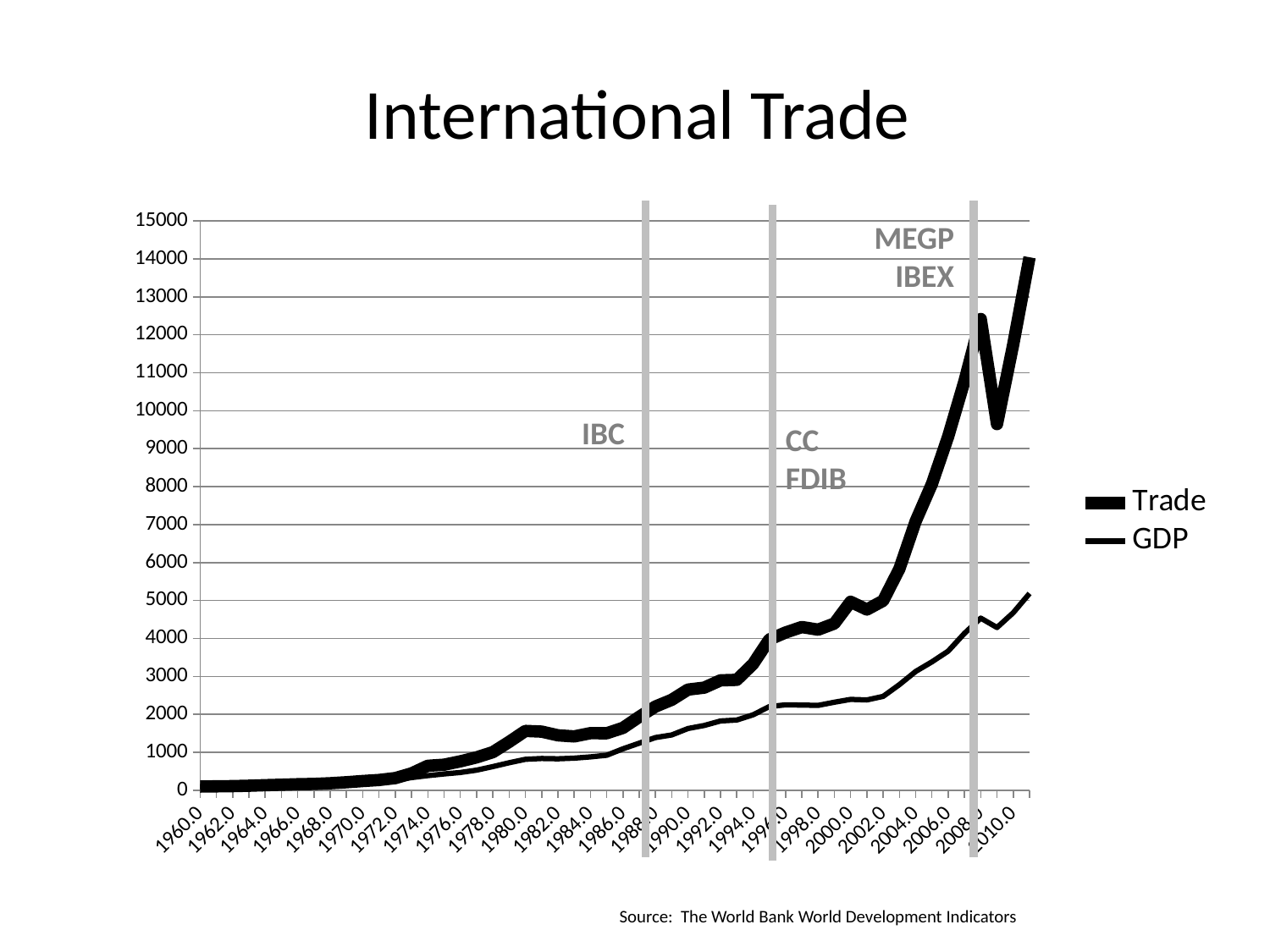
Is the value for Trade in 2000 greater or less than 4000? greater Is the value for Trade in 1960 greater or less than 1000? less What are the two series named in the legend? Trade and GDP Is the value for Trade in 2010 greater or less than 13000? less What kind of chart is shown on the slide? line chart Which series is higher in 2010, Trade or GDP? Trade What is the title of the chart? International Trade What is the highest value shown on the vertical axis? 15000 Does the GDP series generally rise or fall from 1960 to 2010? rise How many series does the legend list? 2 Which series reaches the highest value on the chart? Trade